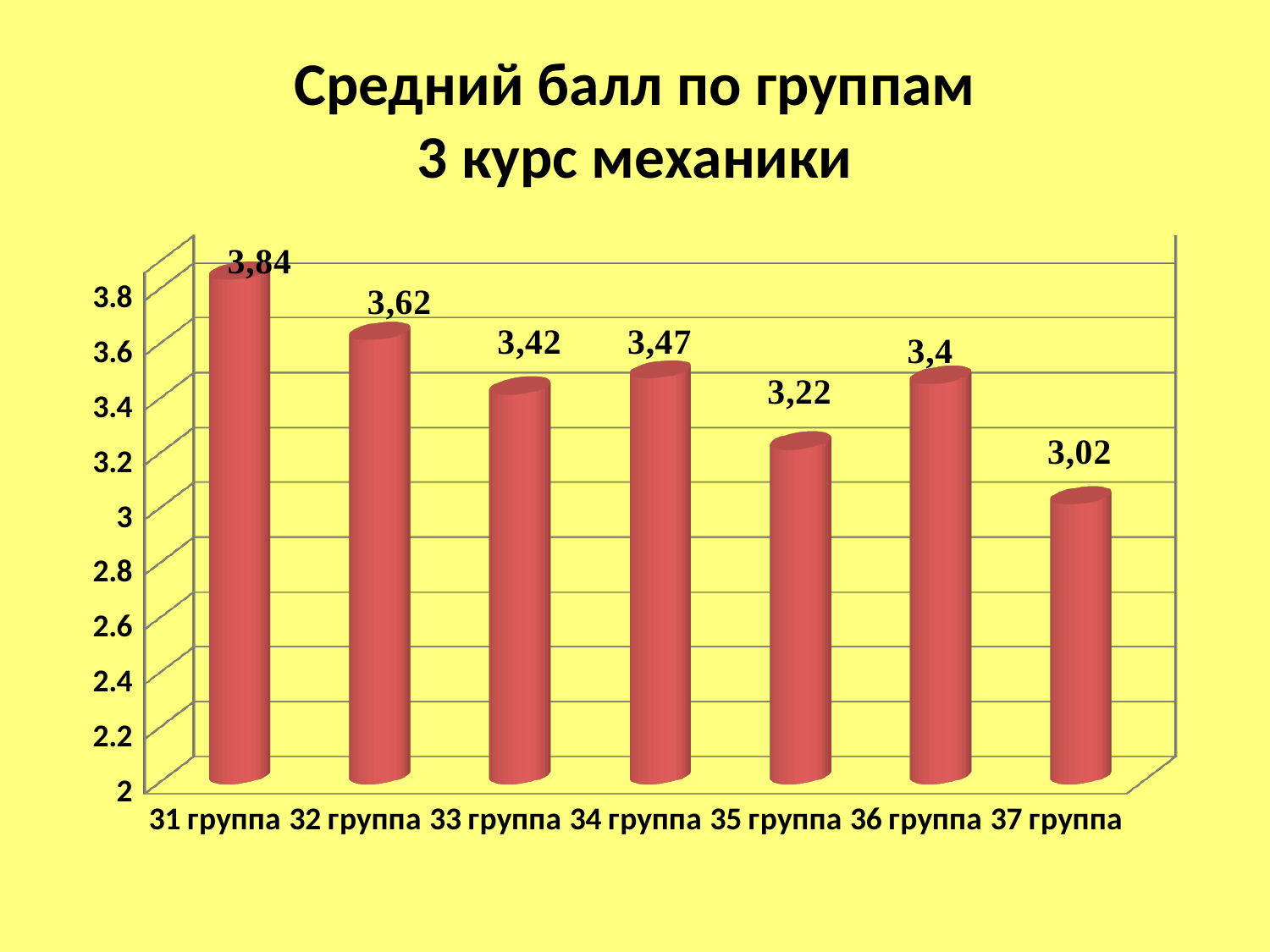
What is the difference between the average scores of 31 группа and 32 группа? 0,22 Which has a higher average score, 33 группа or 34 группа? 34 группа What is the difference between the average scores of 36 группа and 37 группа? 0,38 How many groups are shown on the chart? 7 Which group has the lowest average score? 37 группа Which group has the highest average score? 31 группа What is the title of the chart? Средний балл по группам 3 курс механики Is the value for 35 группа greater or less than 3.4? less What is the average score for 35 группа? 3,22 What kind of chart is shown on the slide? bar chart What is the average score for 31 группа? 3,84 What is the average score for 37 группа? 3,02